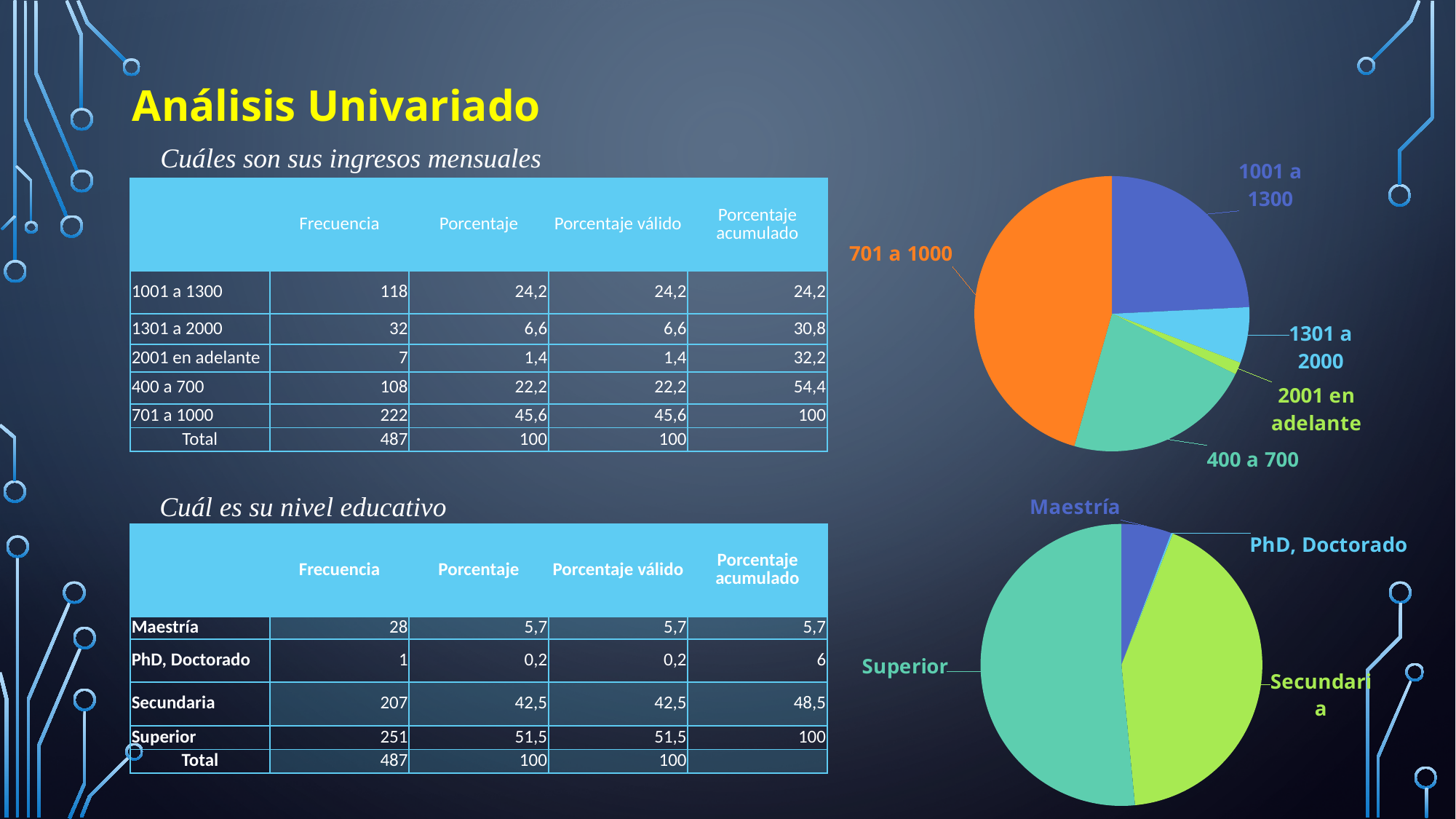
In the upper pie chart (monthly income), which slice is larger: '1001 a 1300' or '1301 a 2000'? 1001 a 1300 In the lower pie chart (education level), which category has the largest slice? Superior What kind of chart is the upper-right chart next to the 'Cuáles son sus ingresos mensuales' table? Pie chart How many slices does the upper pie chart (monthly income) have? 5 In the upper pie chart (monthly income), which category has the largest slice? 701 a 1000 In the upper pie chart (monthly income), which category has the smallest slice? 2001 en adelante In the lower pie chart (education level), which category has the smallest slice? PhD, Doctorado In the lower pie chart (education level), what colour is the 'Secundaria' slice? Light green According to the slide, what percentage share does the '701 a 1000' slice of the upper pie chart represent? 45,6 How many slices does the lower pie chart (education level) have? 4 What kind of chart is the lower-right chart next to the 'Cuál es su nivel educativo' table? Pie chart According to the slide, what is the frequency for the '400 a 700' category shown in the upper pie chart? 108